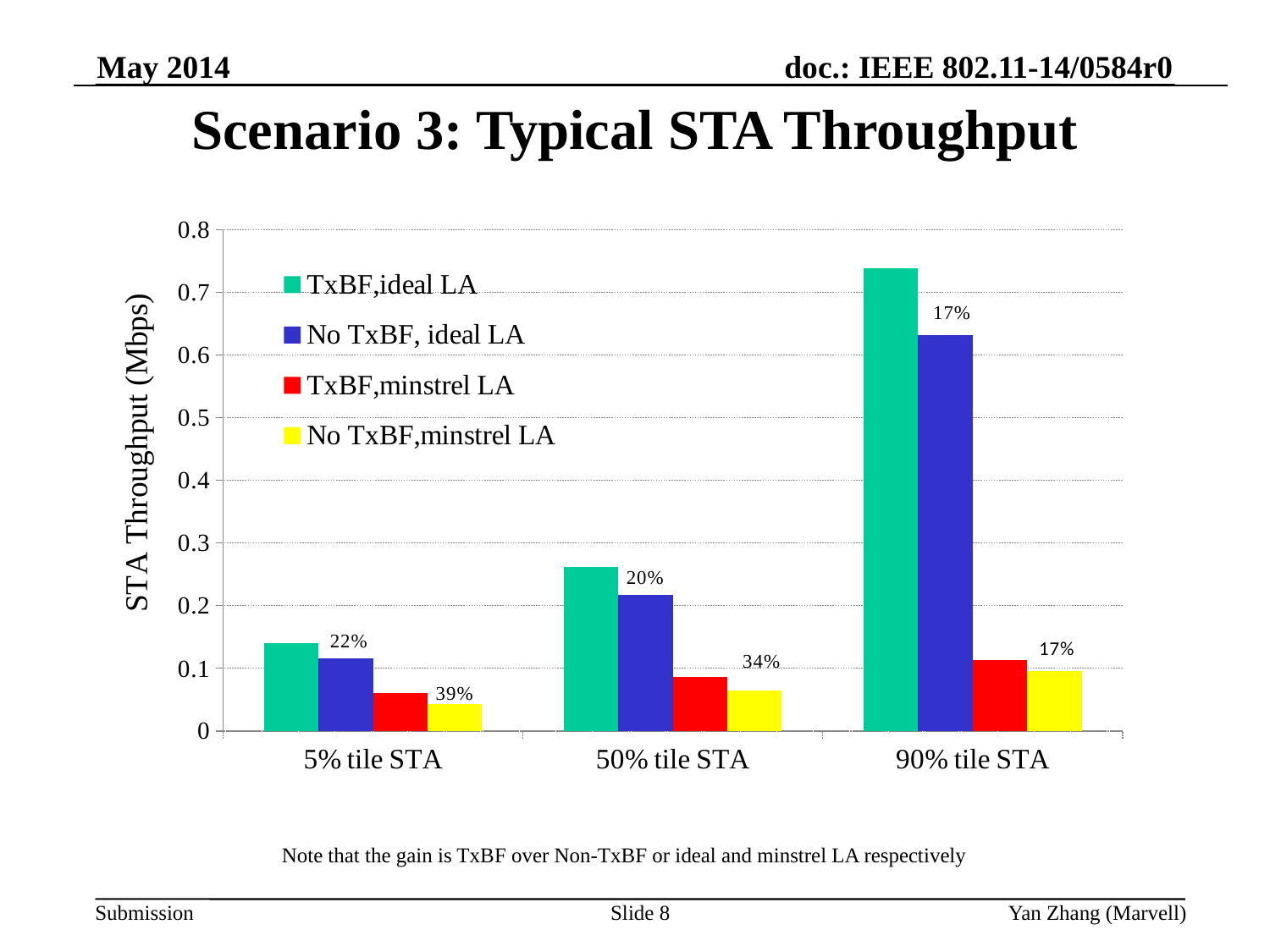
At 50% tile STA, which is larger: TxBF,ideal LA or No TxBF,minstrel LA? TxBF,ideal LA Which category has the highest value for the TxBF,ideal LA series? 90% tile STA How many categories are shown on the x axis of the chart? 3 Is the value for TxBF,ideal LA at 90% tile STA greater or less than 0.7? greater What is the title of the chart's y axis? STA Throughput (Mbps) How many series does the chart's legend list? 4 Which category has the lowest value for the No TxBF,minstrel LA series? 5% tile STA Do the values for the TxBF,ideal LA series rise or fall from 5% tile STA to 90% tile STA? rise Is the value for TxBF,ideal LA at 50% tile STA greater or less than 0.3? less Is the value for TxBF,minstrel LA at 5% tile STA greater or less than 0.1? less What kind of chart is shown on the slide? bar chart